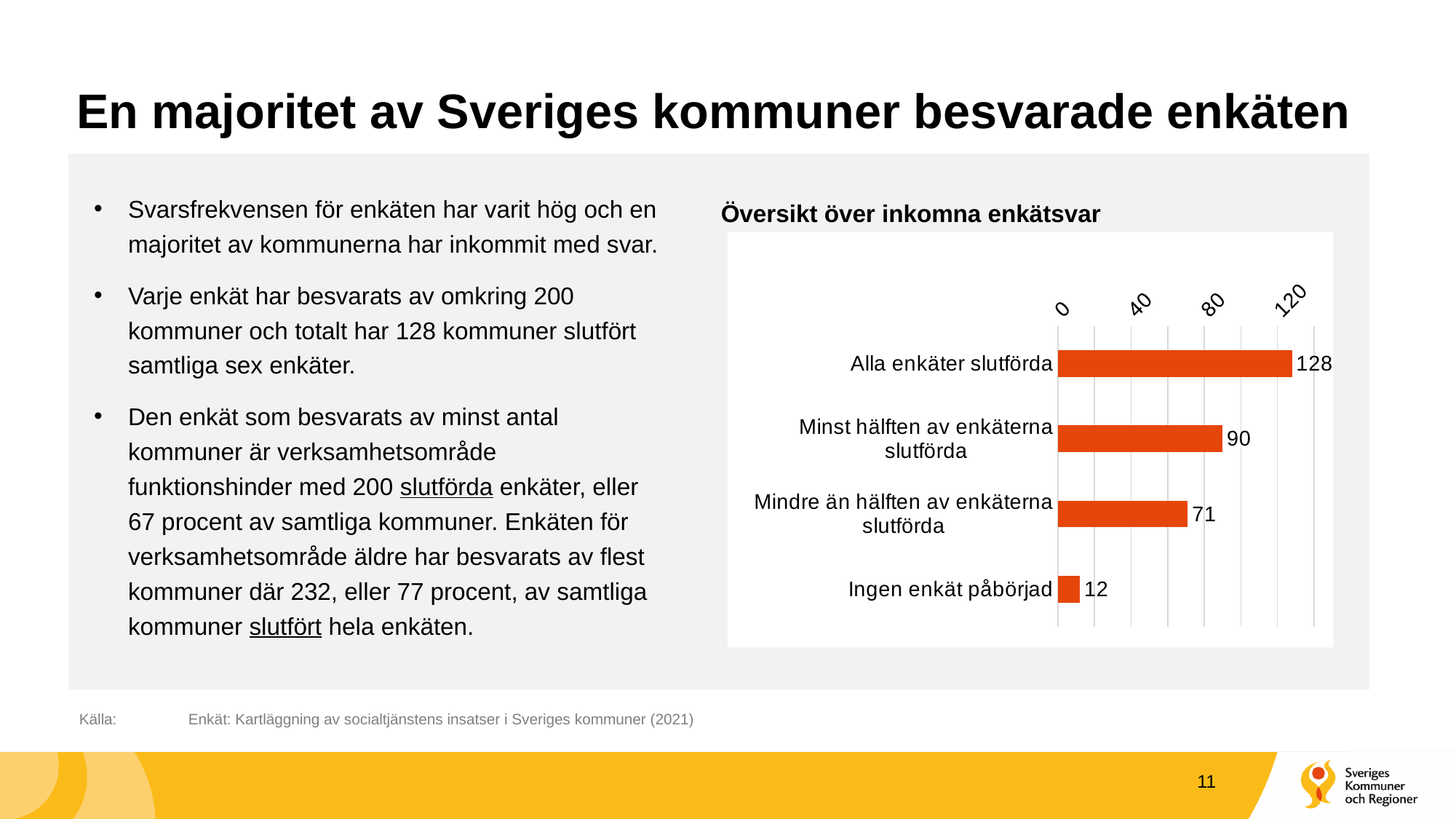
Which category has the highest value? Alla enkäter slutförda What is the value for "Ingen enkät påbörjad"? 12 What is the title of the chart? Översikt över inkomna enkätsvar What is the value for "Minst hälften av enkäterna slutförda"? 90 How many categories are shown in the chart? 4 What is the value for "Mindre än hälften av enkäterna slutförda"? 71 Which is larger: "Minst hälften av enkäterna slutförda" or "Mindre än hälften av enkäterna slutförda"? Minst hälften av enkäterna slutförda What is the difference between "Alla enkäter slutförda" and "Minst hälften av enkäterna slutförda"? 38 What is the value for "Alla enkäter slutförda"? 128 What is the difference between "Mindre än hälften av enkäterna slutförda" and "Ingen enkät påbörjad"? 59 Which category has the lowest value? Ingen enkät påbörjad What kind of chart is shown on the slide? Bar chart